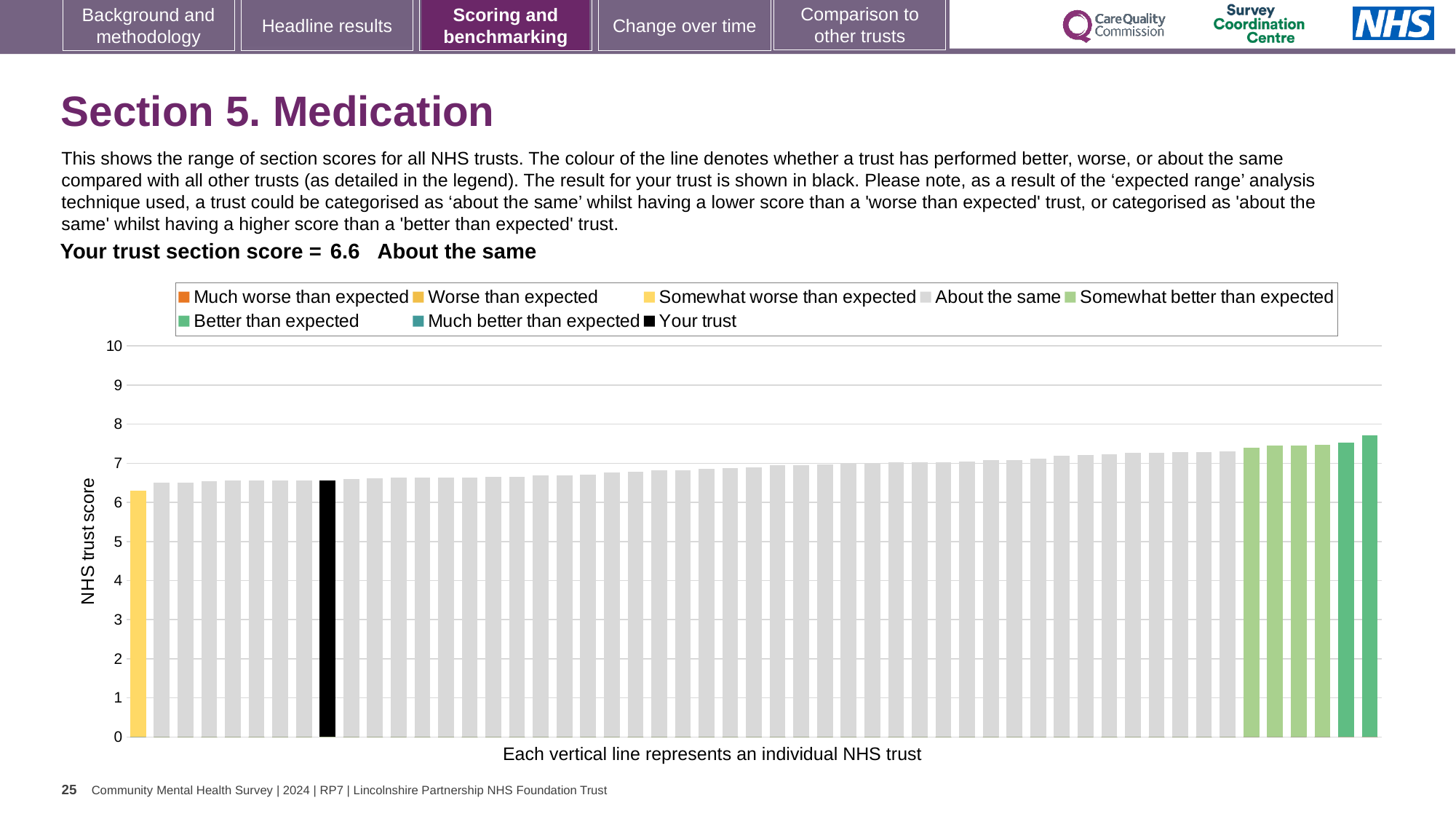
Do the bar values rise or fall from left to right across the chart? rise Is the value of the highest bar in the chart greater or less than 7? greater Is the value of the lowest bar in the chart greater or less than 6? greater What is the section score for your trust shown on the slide? 6.6 Is the rightmost bar in the chart larger or smaller than the leftmost bar? larger Is the value for your trust's bar greater or less than 7? less What colour is the bar representing your trust? black How many entries does the chart legend list? 8 What kind of chart is shown on the slide? bar chart Which benchmarking category is your trust's section score placed in? About the same